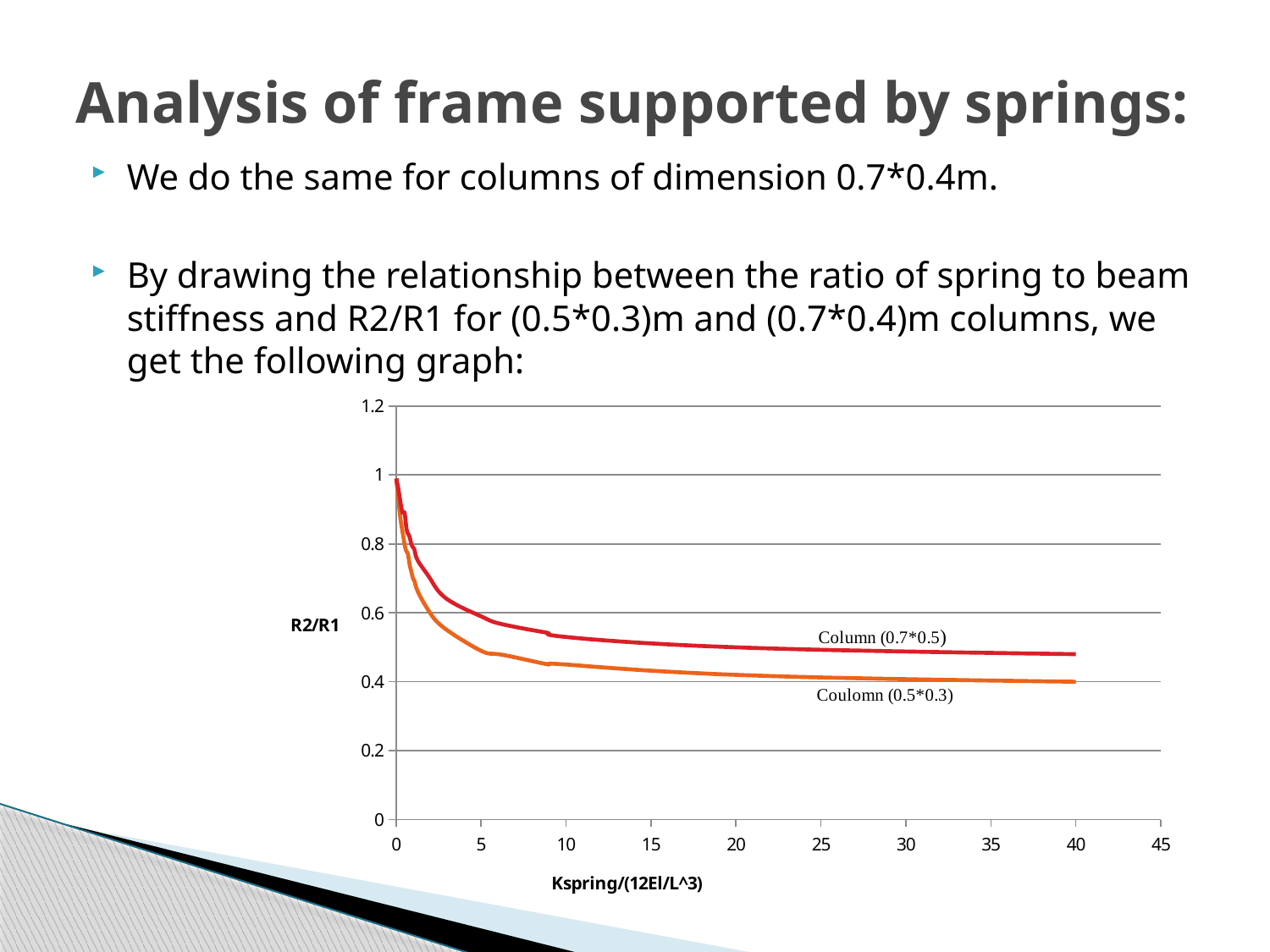
Is the starting R2/R1 value of Column (0.7*0.5) at Kspring/(12EI/L^3) = 0 greater or less than 0.8? greater Is the R2/R1 value for Column (0.7*0.5) at Kspring/(12EI/L^3) = 40 greater or less than 0.6? less What kind of chart is shown on the slide? line chart Which series has the higher R2/R1 values across the chart, Column (0.7*0.5) or Coulomn (0.5*0.3)? Column (0.7*0.5) Is the R2/R1 value for Coulomn (0.5*0.3) at Kspring/(12EI/L^3) = 5 greater or less than 0.6? less How many series are plotted on the chart? 2 Do the R2/R1 values rise or fall as Kspring/(12EI/L^3) increases? fall What is the label of the horizontal axis of the chart? Kspring/(12EI/L^3) What is the label of the vertical axis of the chart? R2/R1